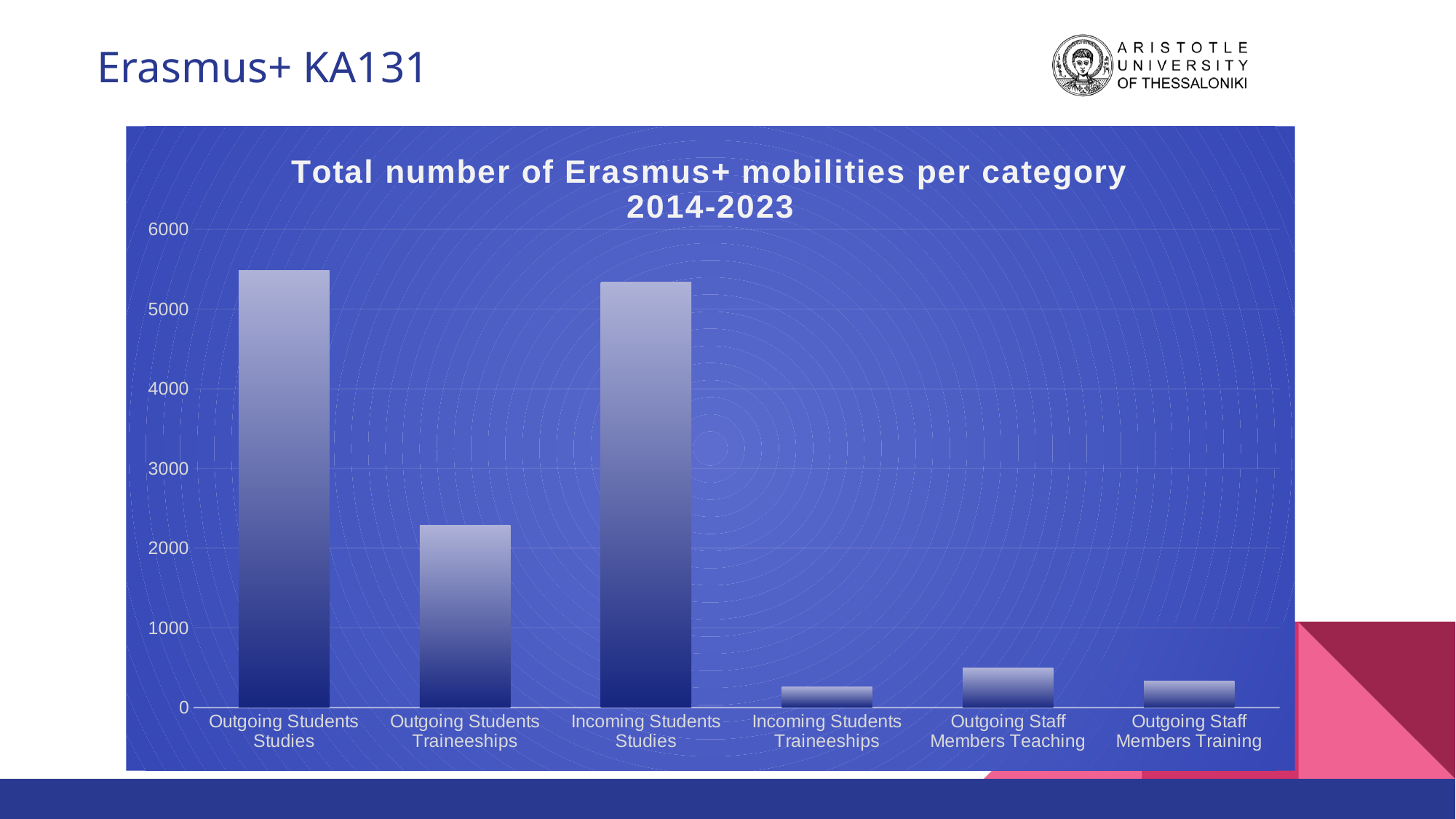
Is the value for Outgoing Students Studies greater or less than 5000? greater What is the title of the chart? Total number of Erasmus+ mobilities per category 2014-2023 Which is larger, the value for Incoming Students Studies or the value for Incoming Students Traineeships? Incoming Students Studies Is the value for Incoming Students Traineeships greater or less than 1000? less How many categories are shown on the x axis of the chart? 6 Which is larger, the value for Outgoing Staff Members Teaching or the value for Outgoing Students Studies? Outgoing Students Studies What kind of chart is shown on the slide? bar chart Is the value for Outgoing Staff Members Teaching greater or less than 1000? less Which is larger, the value for Outgoing Students Traineeships or the value for Outgoing Staff Members Teaching? Outgoing Students Traineeships